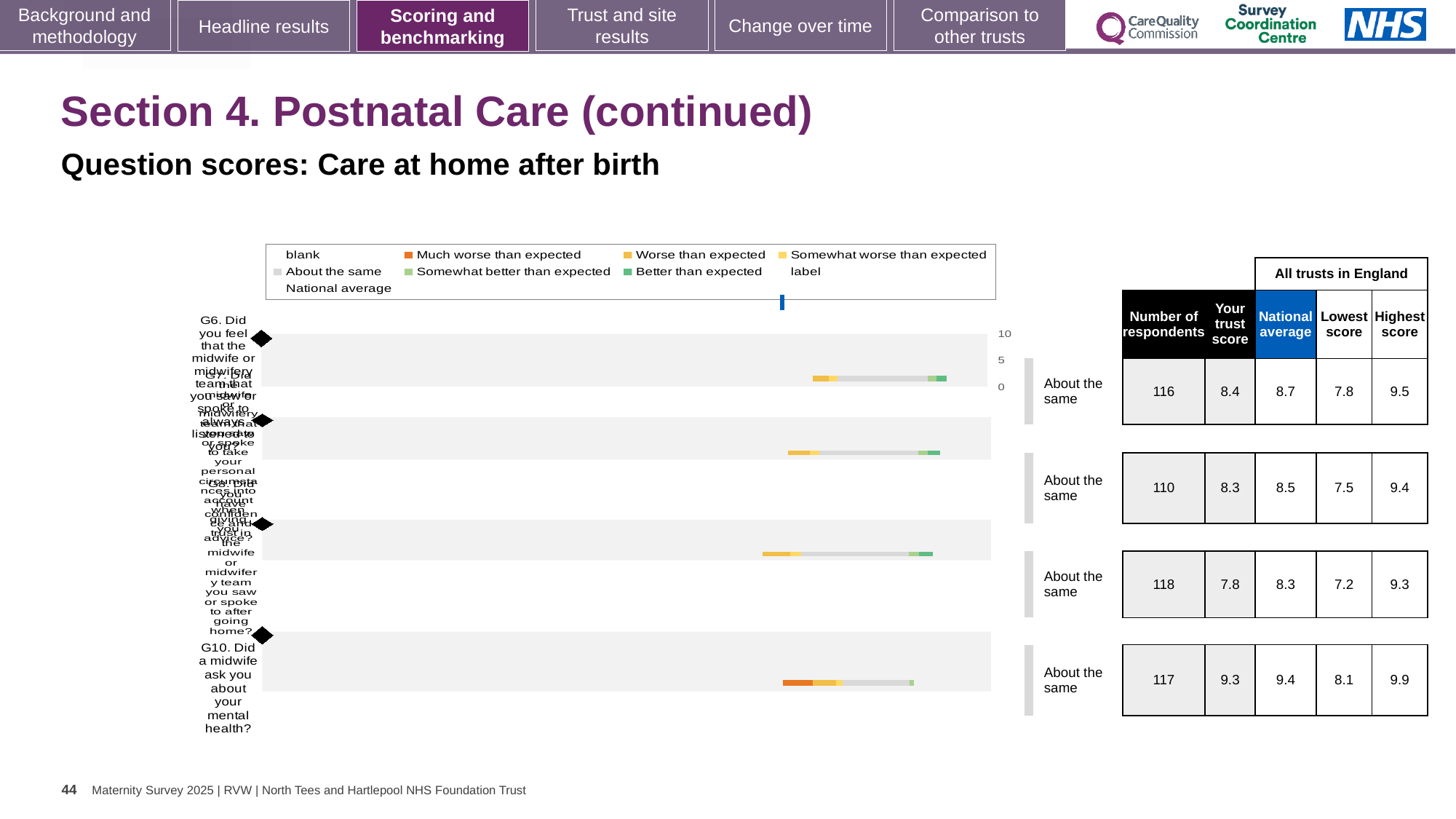
What kind of chart is shown on the slide? bar chart For the third question row (G8), is the trust score or the national average larger? national average (8.3) What is the lowest score among all trusts in England for the first question row (G6)? 7.8 What is the trust score for G10 (Did a midwife ask you about your mental health?)? 9.3 What benchmark rating is shown for every question row on the slide? About the same What is the difference between the national average and the trust score for G10? 0.1 How many question rows (bars) are plotted in the chart? 4 Which question row has the lowest trust score? the third row (G8), 7.8 Which question row has the highest trust score? G10 (fourth row), 9.3 How many respondents are listed for G10 (Did a midwife ask you about your mental health?)? 117 What is the national average for G10 (Did a midwife ask you about your mental health?)? 9.4 What is the highest score among all trusts in England for G10 (Did a midwife ask you about your mental health?)? 9.9